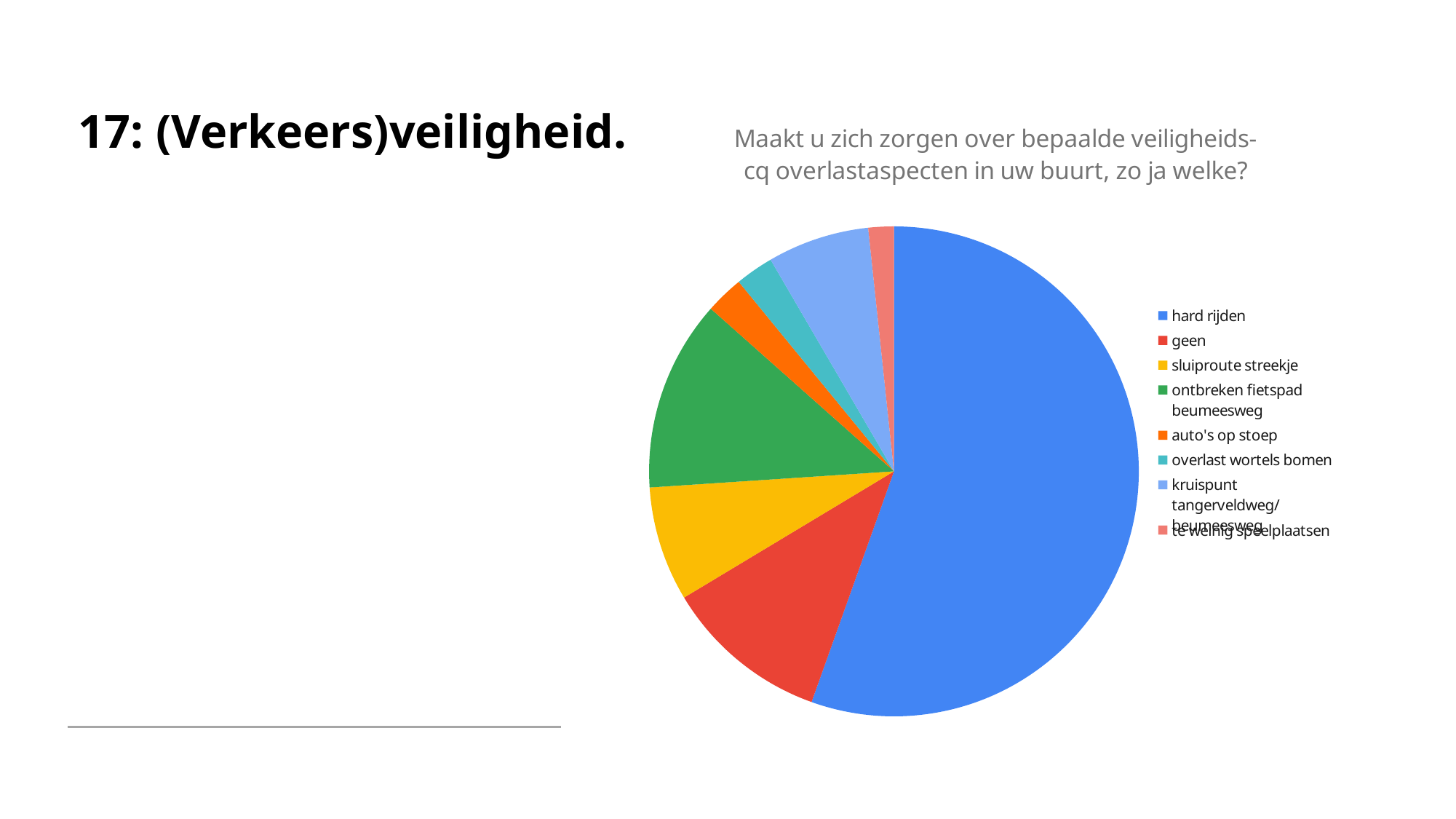
How many categories does the pie chart show? 8 Which slice is larger, 'sluiproute streekje' or 'te weinig speelplaatsen'? sluiproute streekje What is the title of the pie chart? Maakt u zich zorgen over bepaalde veiligheids- cq overlastaspecten in uw buurt, zo ja welke? Which slice is larger, 'ontbreken fietspad beumeesweg' or 'auto's op stoep'? ontbreken fietspad beumeesweg Which category has the largest slice of the pie chart? hard rijden Which slice is larger, 'kruispunt tangerveldweg/beumeesweg' or 'overlast wortels bomen'? kruispunt tangerveldweg/beumeesweg What kind of chart is shown on the slide? pie chart Which category has the smallest slice of the pie chart? te weinig speelplaatsen What colour is the 'hard rijden' slice in the pie chart? blue Does the 'hard rijden' slice take up more or less than half of the pie? more